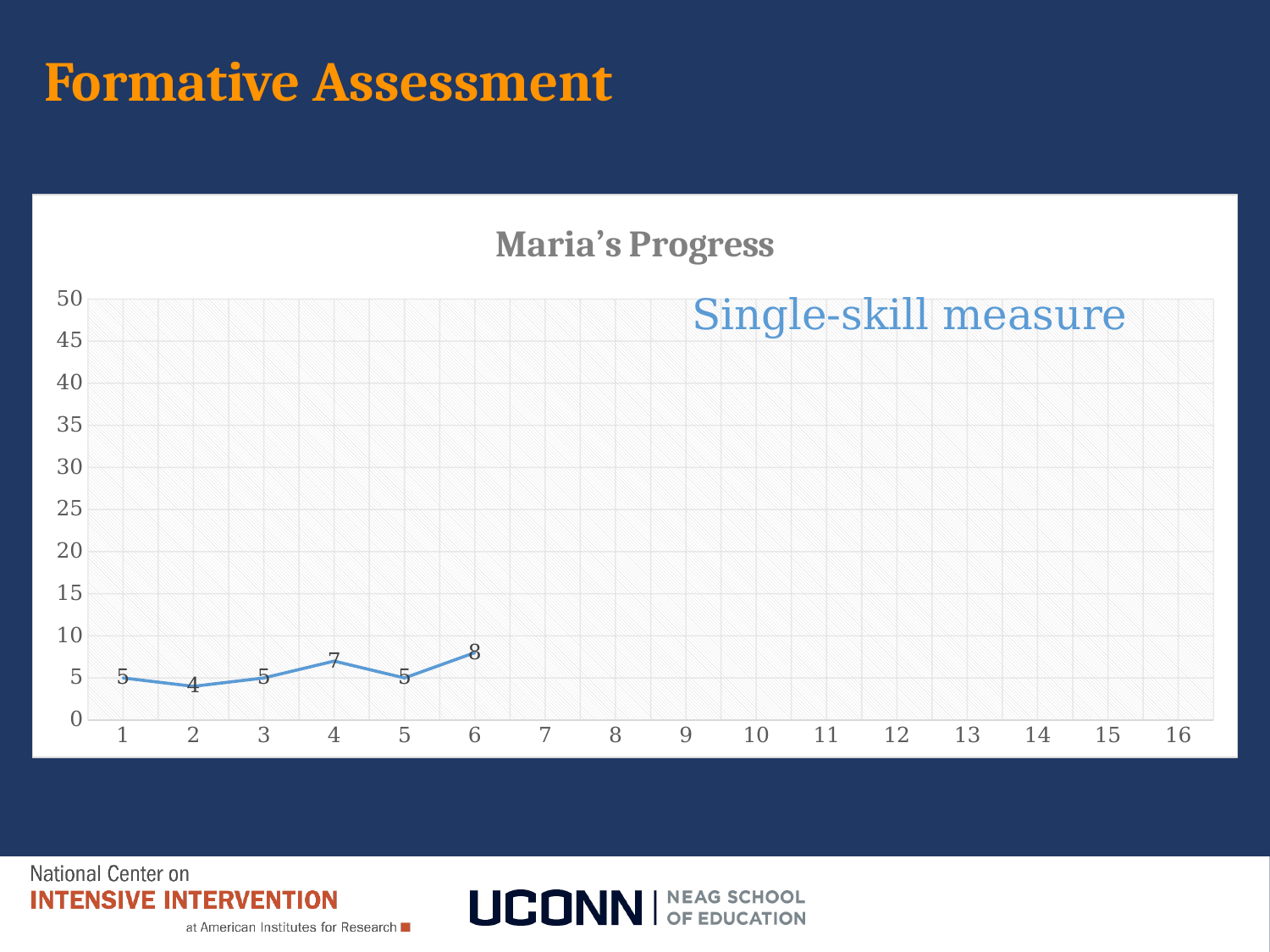
How many data points are plotted on the line? 6 At which x-axis point is the value highest? 6 What is the difference between the values at point 6 and point 2? 4 What is the title of the chart? Maria's Progress What type of chart is shown on the slide? line chart Is the value at point 6 greater or less than 10? less What is the value at point 4? 7 Which is larger, the value at point 4 or the value at point 5? point 4 What is the value at point 6? 8 At which x-axis point is the value lowest? 2 What is the value at point 1? 5 What text label appears in the upper right of the plot area? Single-skill measure